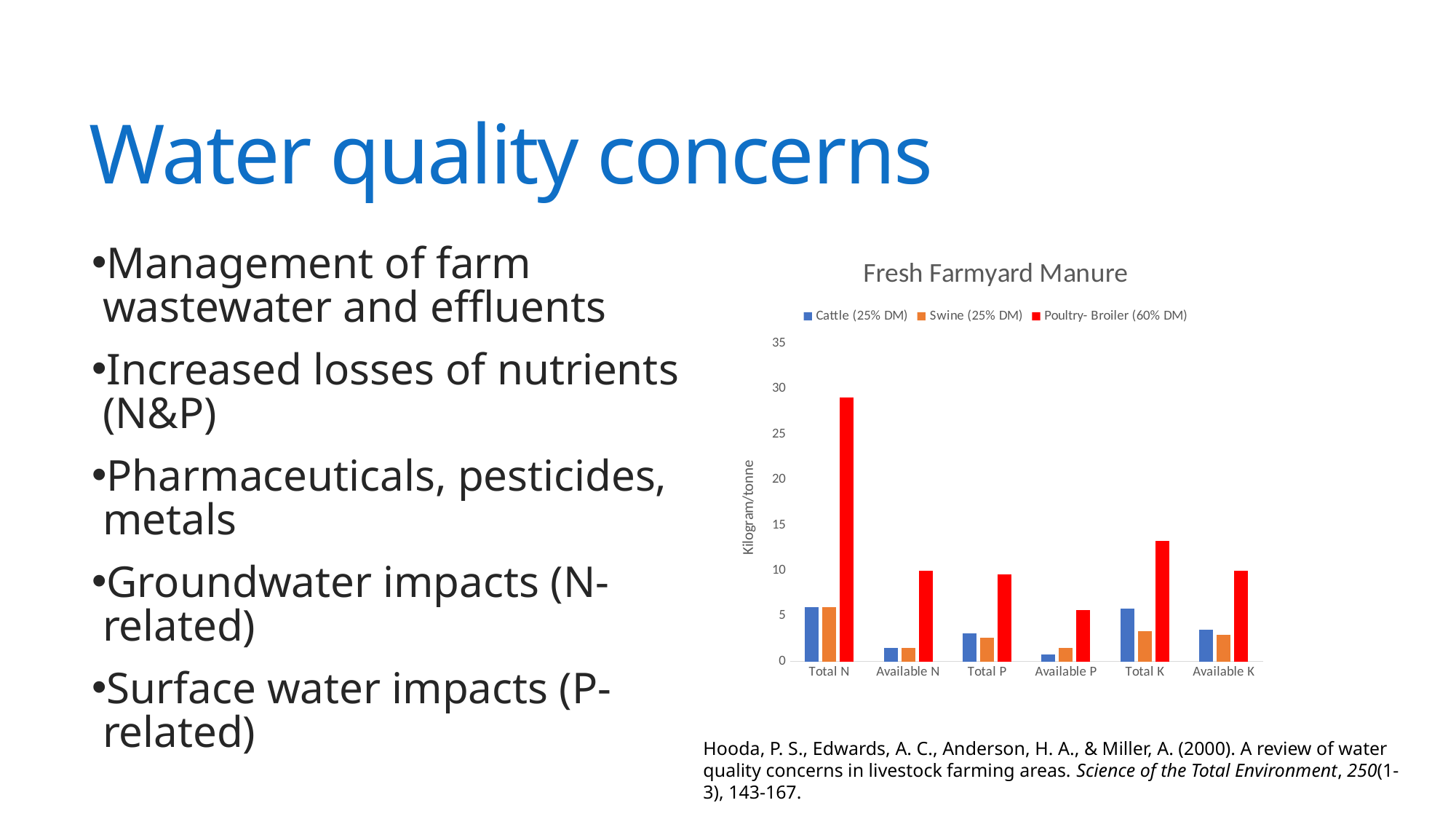
Which is larger in the Available P category: Cattle (25% DM) or Poultry- Broiler (60% DM)? Poultry- Broiler (60% DM) How many series does the legend of the Fresh Farmyard Manure chart list? 3 What kind of chart is shown on the slide? Bar chart Which is larger in the Total K category: Cattle (25% DM) or Swine (25% DM)? Cattle (25% DM) In which category does the Poultry- Broiler (60% DM) series reach its highest value? Total N What is the title of the chart on the slide? Fresh Farmyard Manure Is the value for Poultry- Broiler (60% DM) in Total K greater or less than 10? greater Is the value for Poultry- Broiler (60% DM) in Total N greater or less than 25? greater Is the value for Cattle (25% DM) in Total N greater or less than 10? less Which series has the highest bar in the Total N category? Poultry- Broiler (60% DM) What is the label on the vertical axis of the chart? Kilogram/tonne How many categories are shown on the x axis of the Fresh Farmyard Manure chart? 6